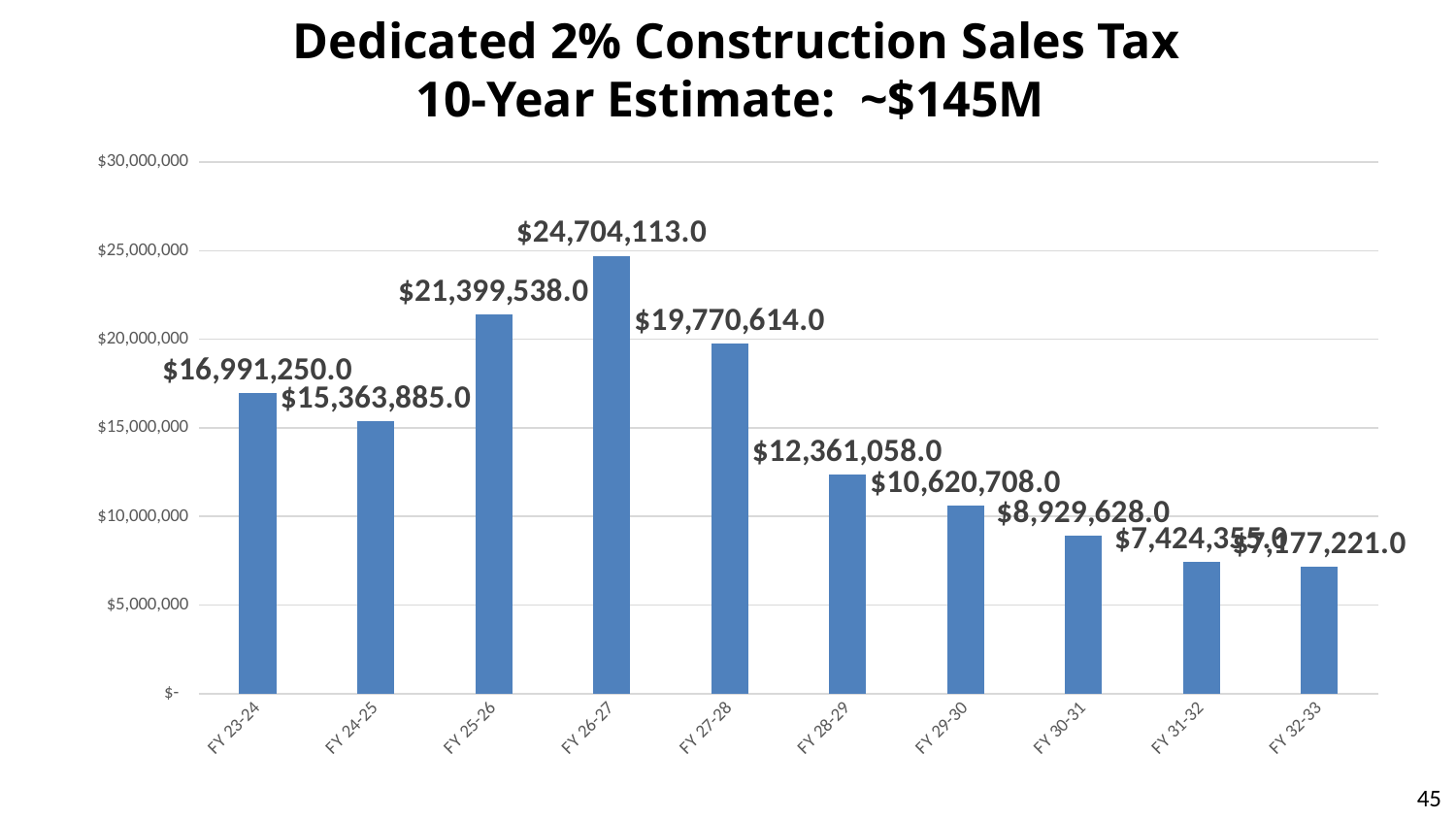
What is the difference between the values for FY 26-27 and FY 25-26? $3,304,575.0 What is the difference between the values for FY 23-24 and FY 24-25? $1,627,365.0 Is the value for FY 30-31 greater or less than $10,000,000? less What is the 10-year estimate stated in the chart title? ~$145M Which fiscal year has the highest value? FY 26-27 How many fiscal years are shown on the x axis? 10 What is the value for FY 26-27? $24,704,113.0 What is the value for FY 23-24? $16,991,250.0 Which is larger, the value for FY 24-25 or the value for FY 27-28? FY 27-28 What is the value for FY 28-29? $12,361,058.0 Do the values rise or fall from FY 26-27 to FY 32-33? fall What kind of chart is shown on the slide? bar chart